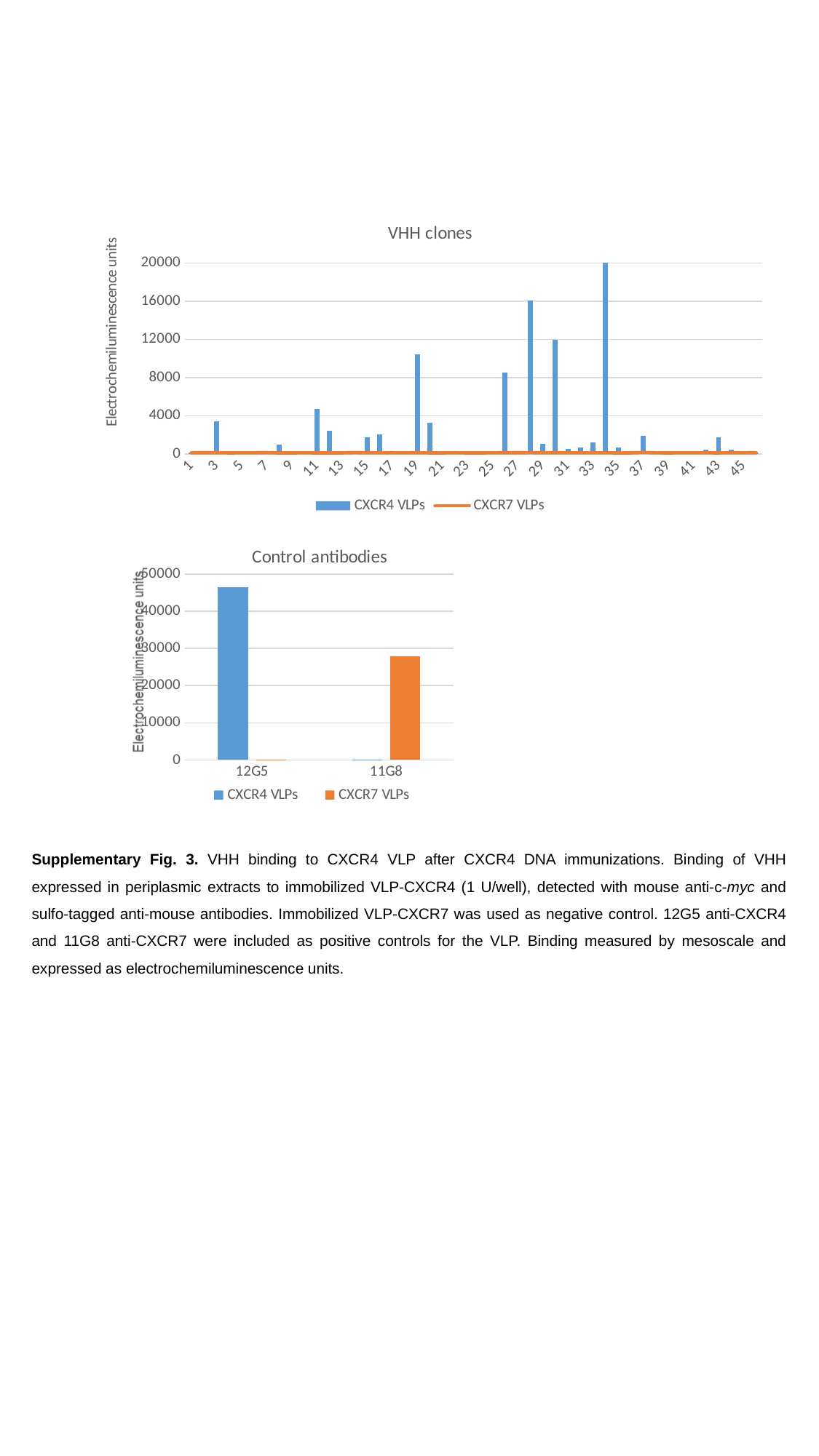
How many series does the legend of the 'Control antibodies' chart list? 2 In the 'Control antibodies' chart, is the CXCR4 VLPs value for 12G5 greater or less than 40000? greater How many series does the legend of the 'VHH clones' chart list? 2 In the 'VHH clones' chart, which series is drawn as a line rather than bars? CXCR7 VLPs What kind of chart is the 'Control antibodies' chart? bar chart In the 'VHH clones' chart, is the tallest CXCR4 VLPs bar greater or less than 16000? greater In the 'Control antibodies' chart, which series has the larger value for 11G8? CXCR7 VLPs In the 'Control antibodies' chart, is the CXCR7 VLPs value for 11G8 greater or less than 30000? less In the 'Control antibodies' chart, which series has the larger value for 12G5? CXCR4 VLPs How many categories are shown on the x axis of the 'Control antibodies' chart? 2 What is the y-axis label of the 'VHH clones' chart? Electrochemiluminescence units In the 'Control antibodies' chart, which category has the higher CXCR4 VLPs value, 12G5 or 11G8? 12G5